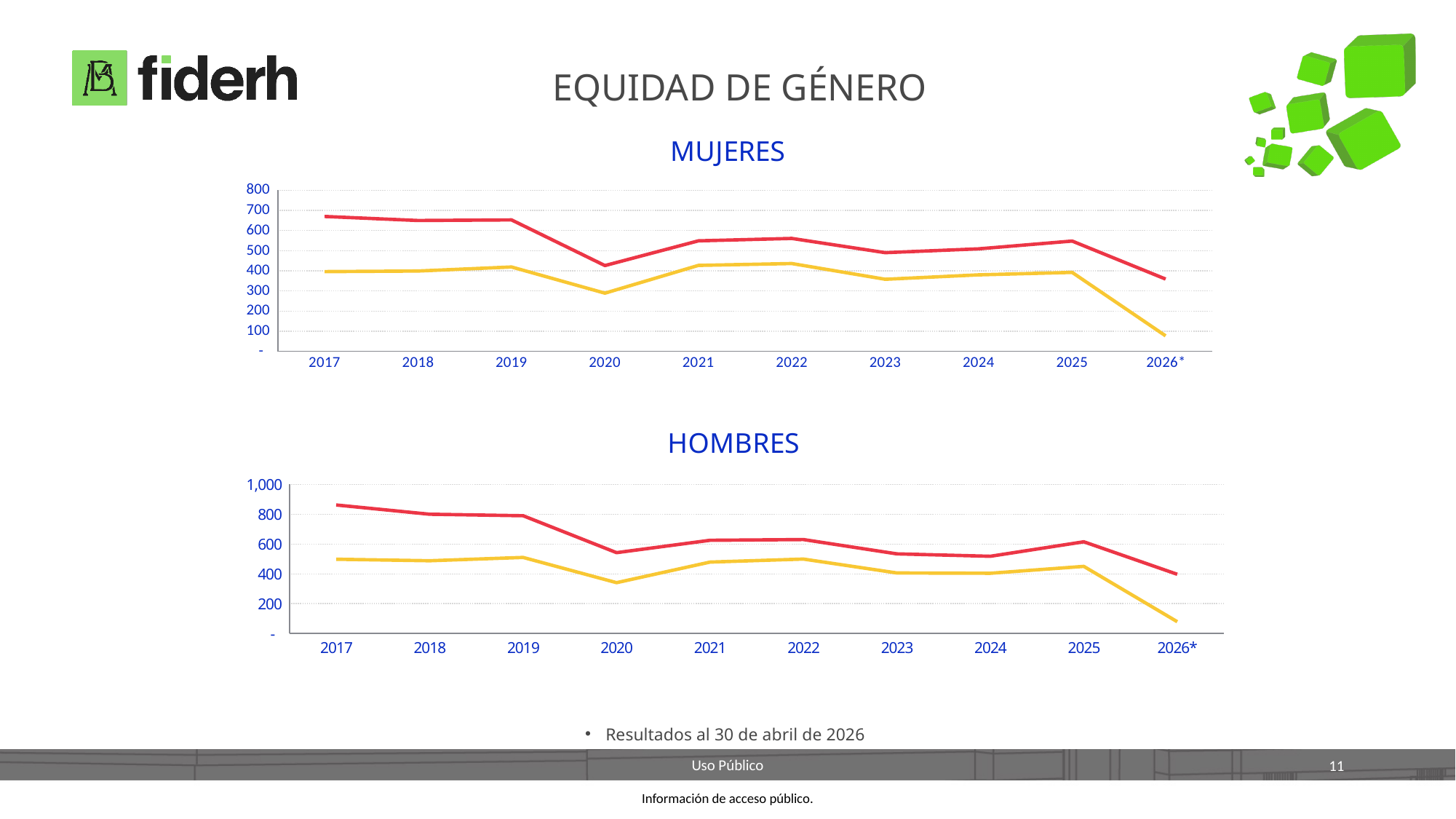
What kind of chart is the MUJERES chart? line chart In the MUJERES chart, which line is higher in 2021, the red line or the yellow line? red line In the HOMBRES chart, which year has the highest value on the red line? 2017 How many years are shown on the x axis of the MUJERES chart? 10 What kind of chart is the HOMBRES chart? line chart How many lines are plotted in the HOMBRES chart? 2 In the HOMBRES chart, is the value of the yellow line for 2020 greater or less than 400? less In the MUJERES chart, is the value of the red line for 2017 greater or less than 600? greater In the MUJERES chart, is the value of the red line for 2020 greater or less than 500? less In the MUJERES chart, which year has the lowest value on the yellow line? 2026* In the MUJERES chart, does the red line rise or fall from 2025 to 2026*? fall